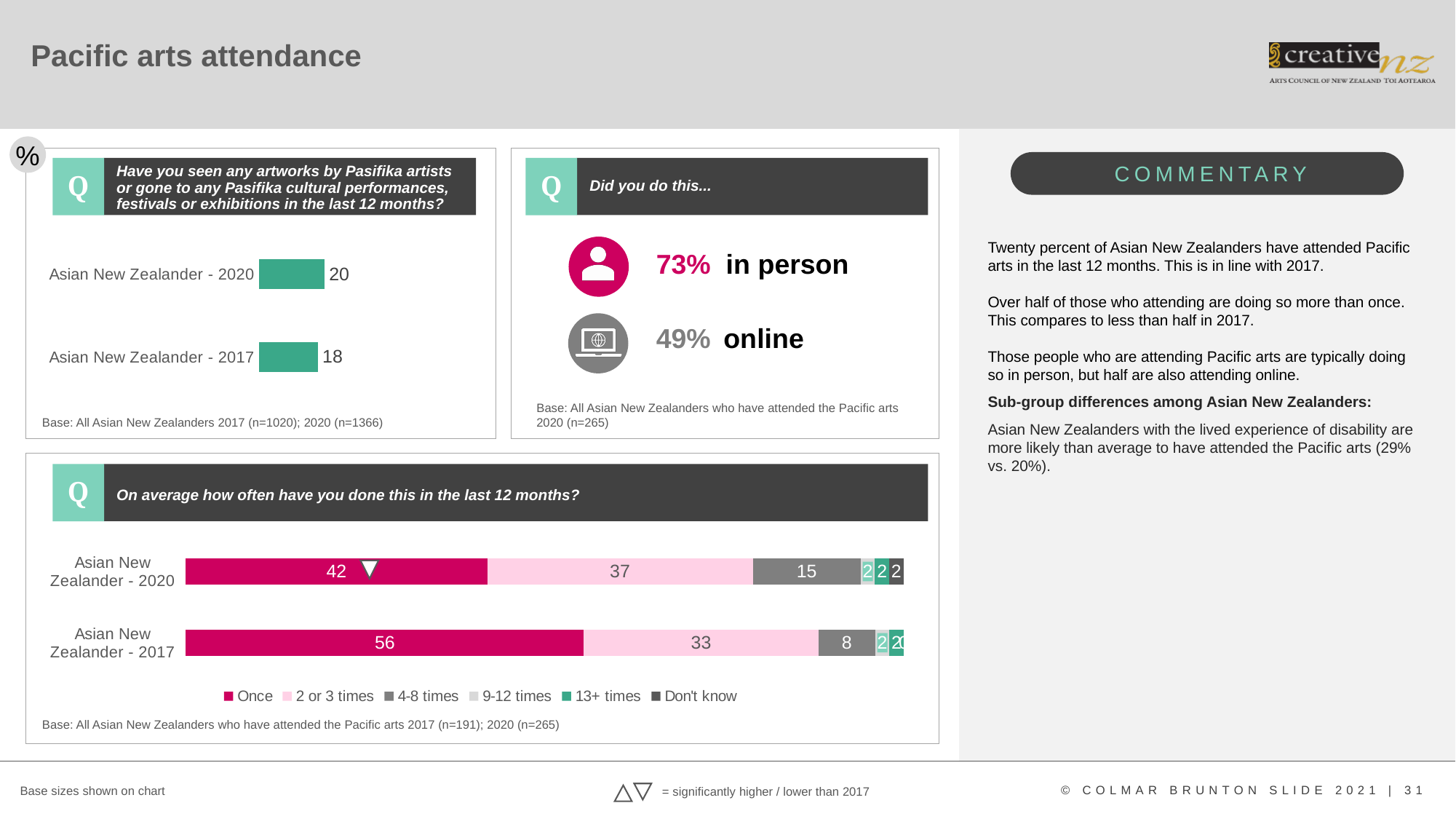
What kind of chart is the chart 'Have you seen any artworks by Pasifika artists...'? Bar chart In the chart 'Have you seen any artworks by Pasifika artists...', what is the difference between the 2020 and 2017 values? 2 In the chart 'On average how often have you done this in the last 12 months?', how many series does the legend list? 6 In the chart 'On average how often have you done this in the last 12 months?', what is the '2 or 3 times' value for Asian New Zealander - 2017? 33 In the chart 'On average how often have you done this in the last 12 months?', what is the '4-8 times' value for Asian New Zealander - 2020? 15 In the chart 'Have you seen any artworks by Pasifika artists...', what is the value for Asian New Zealander - 2020? 20 In the chart 'On average how often have you done this in the last 12 months?', what is the 'Once' value for Asian New Zealander - 2020? 42 In the chart 'On average how often have you done this in the last 12 months?', what is the difference between the 'Once' values for 2017 and 2020? 14 In the chart 'Have you seen any artworks by Pasifika artists...', which year has the higher value, 2020 or 2017? 2020 In the chart 'On average how often have you done this in the last 12 months?', what is the total of the stacked bar for Asian New Zealander - 2020? 100 In the chart 'On average how often have you done this in the last 12 months?', which segment is the largest for Asian New Zealander - 2017? Once In the chart 'Have you seen any artworks by Pasifika artists...', what is the value for Asian New Zealander - 2017? 18